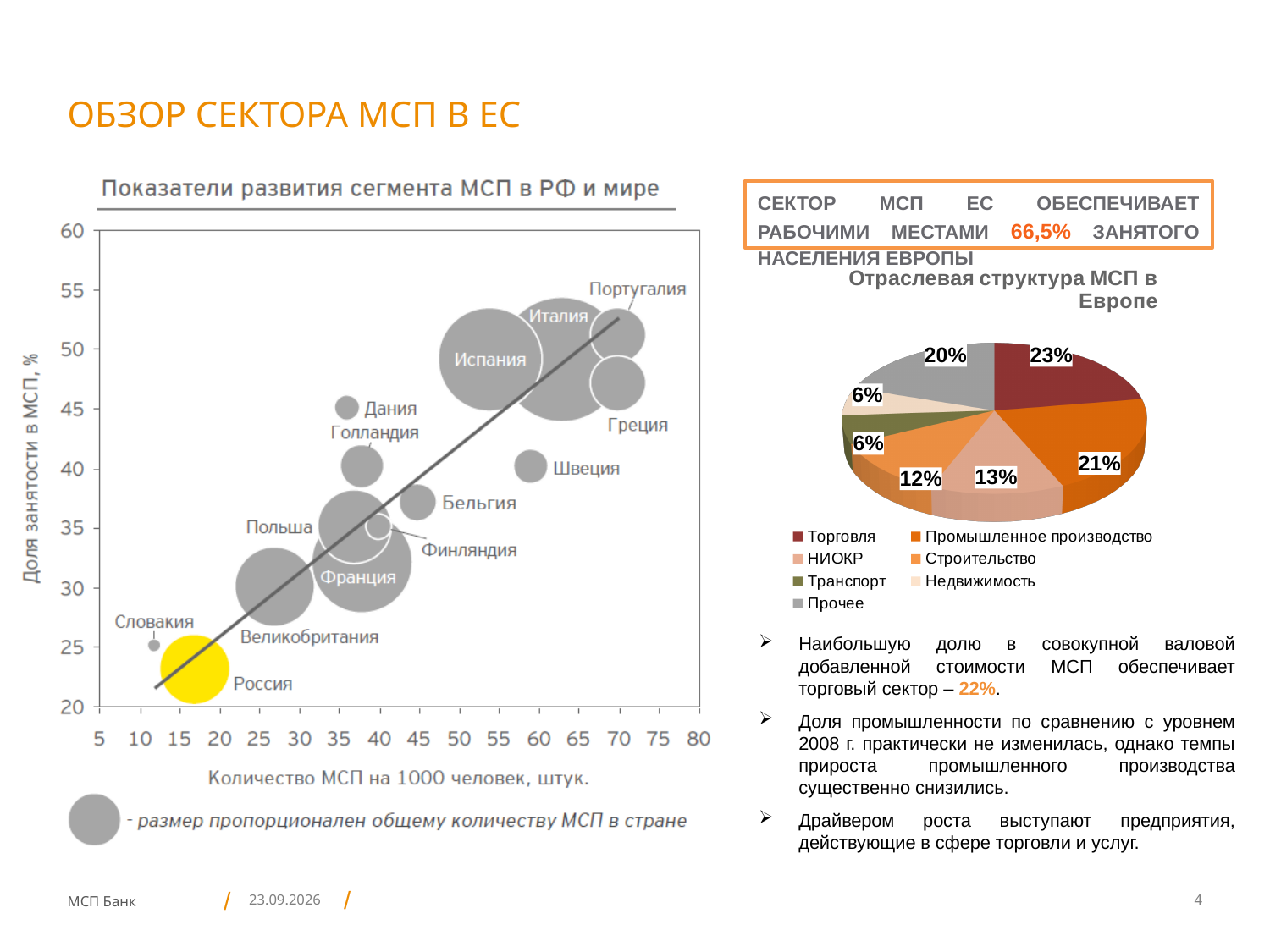
On the pie chart 'Отраслевая структура МСП в Европе', what share does Торговля have? 23% On the pie chart 'Отраслевая структура МСП в Европе', what share does НИОКР have? 13% On the pie chart 'Отраслевая структура МСП в Европе', what is the difference between the shares of Торговля and Строительство? 11% On the chart 'Показатели развития сегмента МСП в РФ и мире', which country's bubble is highlighted in yellow? Россия How many entries does the legend of the pie chart 'Отраслевая структура МСП в Европе' list? 7 On the pie chart 'Отраслевая структура МСП в Европе', what share does Промышленное производство have? 21% On the pie chart 'Отраслевая структура МСП в Европе', which is larger: the share of Прочее or the share of НИОКР? Прочее On the chart 'Показатели развития сегмента МСП в РФ и мире', is the share of employment in SMEs for Португалия greater or less than 50%? greater On the chart 'Показатели развития сегмента МСП в РФ и мире', how many countries are plotted? 14 What kind of chart is 'Показатели развития сегмента МСП в РФ и мире'? Bubble chart On the pie chart 'Отраслевая структура МСП в Европе', which sector has the largest share? Торговля On the chart 'Показатели развития сегмента МСП в РФ и мире', does the share of employment in SMEs generally rise or fall as the number of SMEs per 1000 people increases? rise